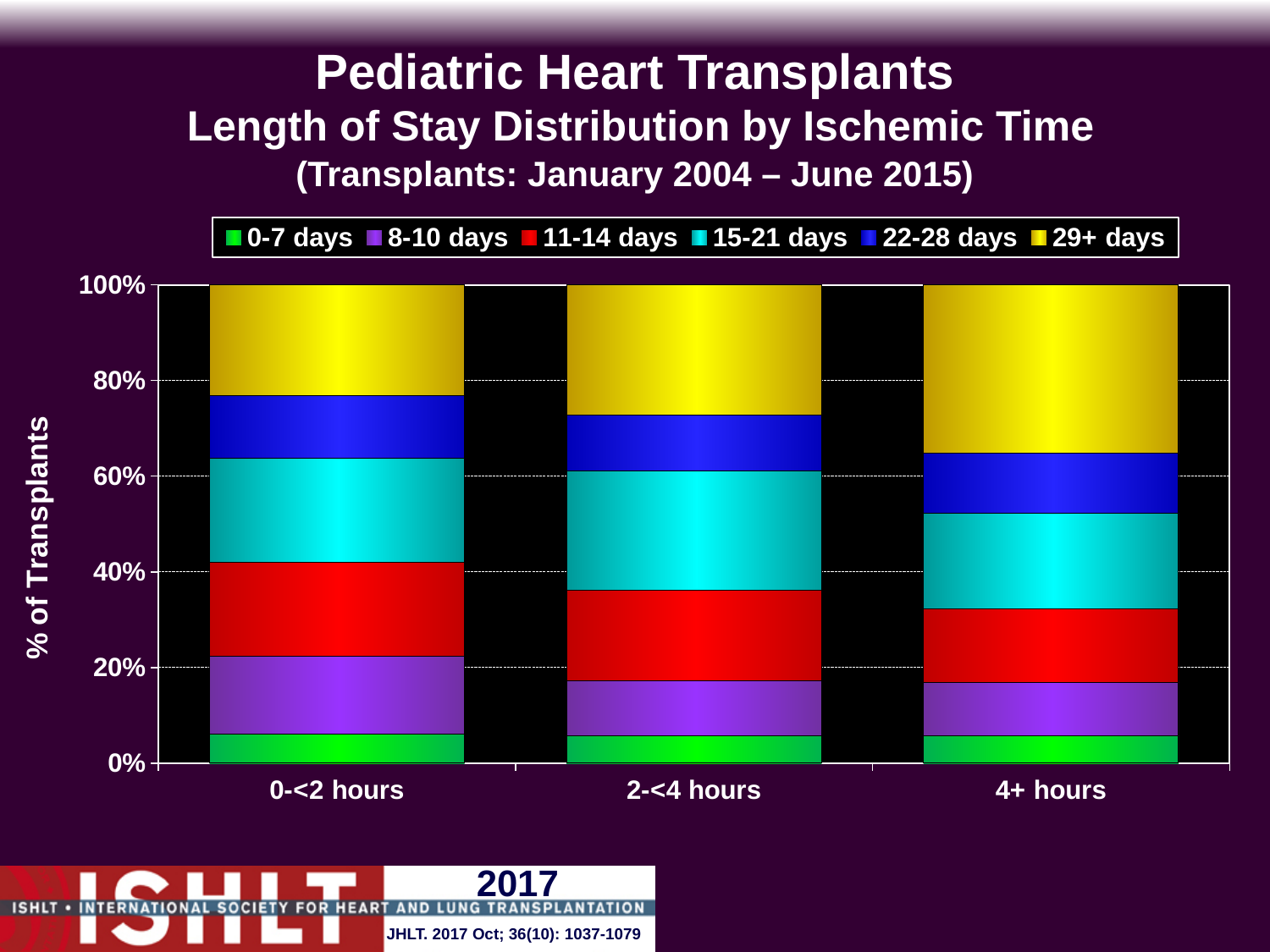
What kind of chart is shown on the slide? Stacked bar chart What is the label on the y axis? % of Transplants Is the 0-7 days share for 0-<2 hours greater or less than 20%? less Which ischemic time category has the largest 8-10 days share? 0-<2 hours Which colour represents the 15-21 days series in the legend? Cyan Is the 29+ days share for 4+ hours greater or less than 20%? greater Which is larger, the 29+ days share for 4+ hours or for 0-<2 hours? 4+ hours How many ischemic time categories are shown on the x axis? 3 What is the total of the stacked bar for 2-<4 hours? 100% Which ischemic time category has the largest 29+ days share? 4+ hours Does the 29+ days share rise or fall as ischemic time increases along the x axis? rise How many length-of-stay series does the legend list? 6